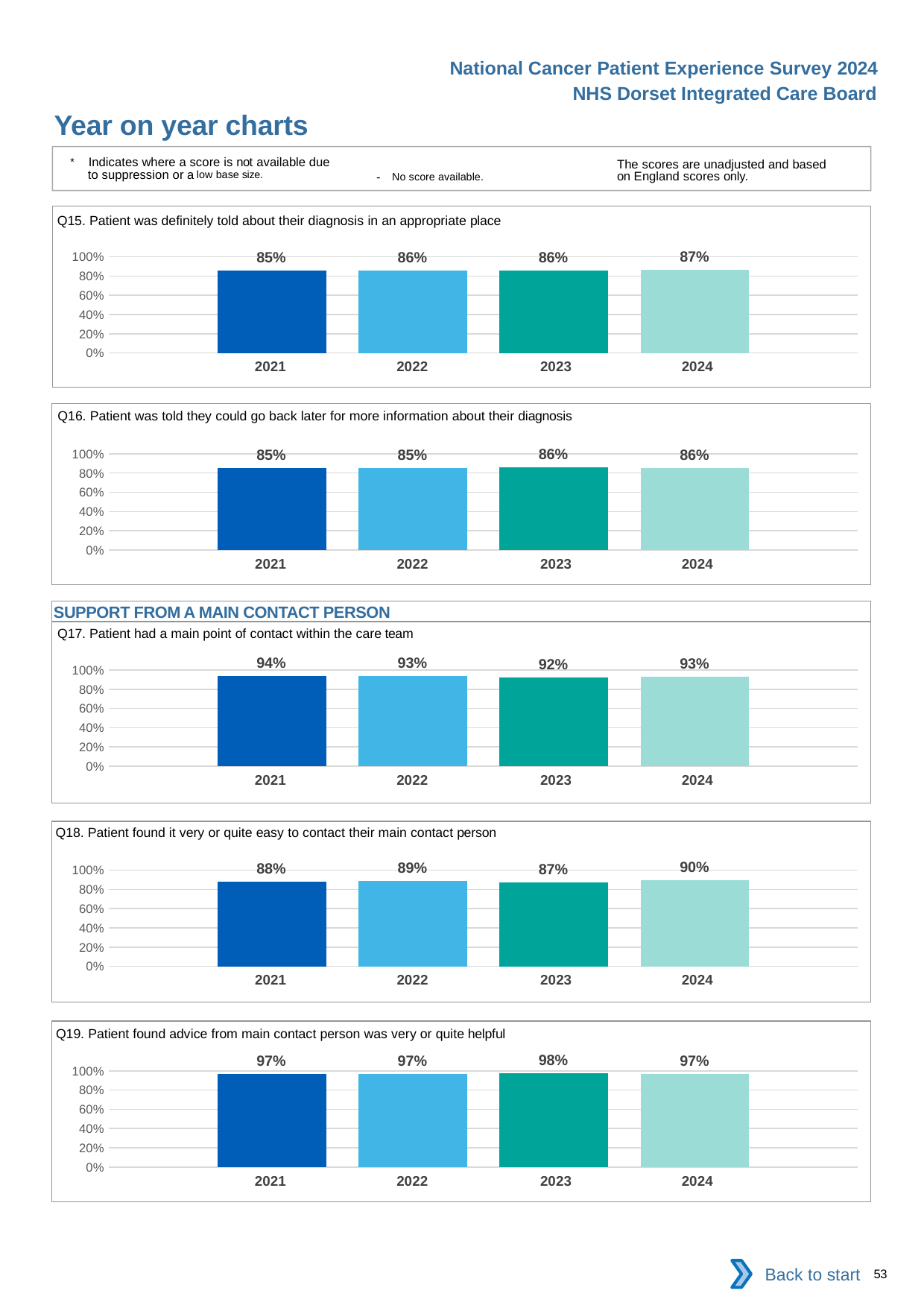
In the Q18 chart (patient found it very or quite easy to contact their main contact person), which year has the highest value? 2024 In the Q19 chart (patient found advice from main contact person was very or quite helpful), which year has the highest value? 2023 What kind of chart is used for Q18? bar chart In the Q15 chart, which year has the lowest value? 2021 How many years are plotted in the Q15 chart? 4 In the Q17 chart (patient had a main point of contact within the care team), which year has the highest value? 2021 In the Q18 chart, what is the difference between the 2024 value and the 2023 value? 3% In the Q17 chart, what is the value for 2023? 92% In the Q15 chart (patient was definitely told about their diagnosis in an appropriate place), what is the value for 2024? 87% In the Q16 chart, what is the difference between the 2024 value and the 2021 value? 1% In the Q19 chart, is the value for 2022 larger or smaller than the value for 2023? smaller In the Q16 chart (patient was told they could go back later for more information about their diagnosis), what is the value for 2022? 85%